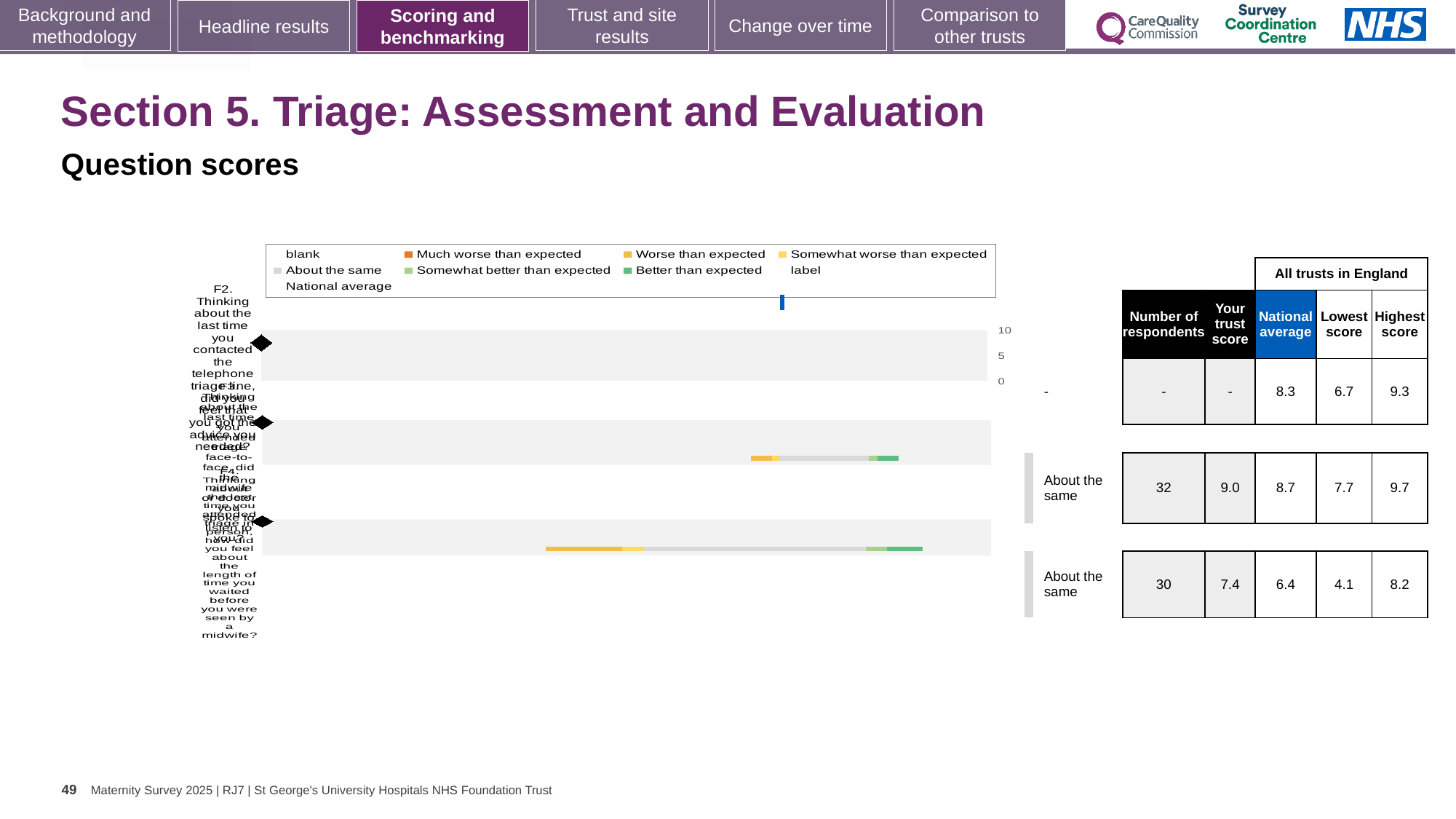
In the chart legend, which colour represents 'Better than expected'? green What is the national average score for the second question row (F3) in the table? 8.7 What is the number of respondents for the second question row (F3)? 32 What is the highest score across all trusts in England for the third question row (F4)? 8.2 What kind of chart is shown on the slide? bar chart In the chart legend, which colour represents 'Much worse than expected'? orange Which question row has the highest national average score? F3 (second row), 8.7 What is the trust score for the third question row (F4) in the table? 7.4 What is the lowest score across all trusts in England for the first question row (F2)? 6.7 What is the difference between the trust score and the national average for the third question row (F4)? 1.0 Is the trust score for the second question row (F3) larger or smaller than its national average? larger How many entries does the chart legend list? 9